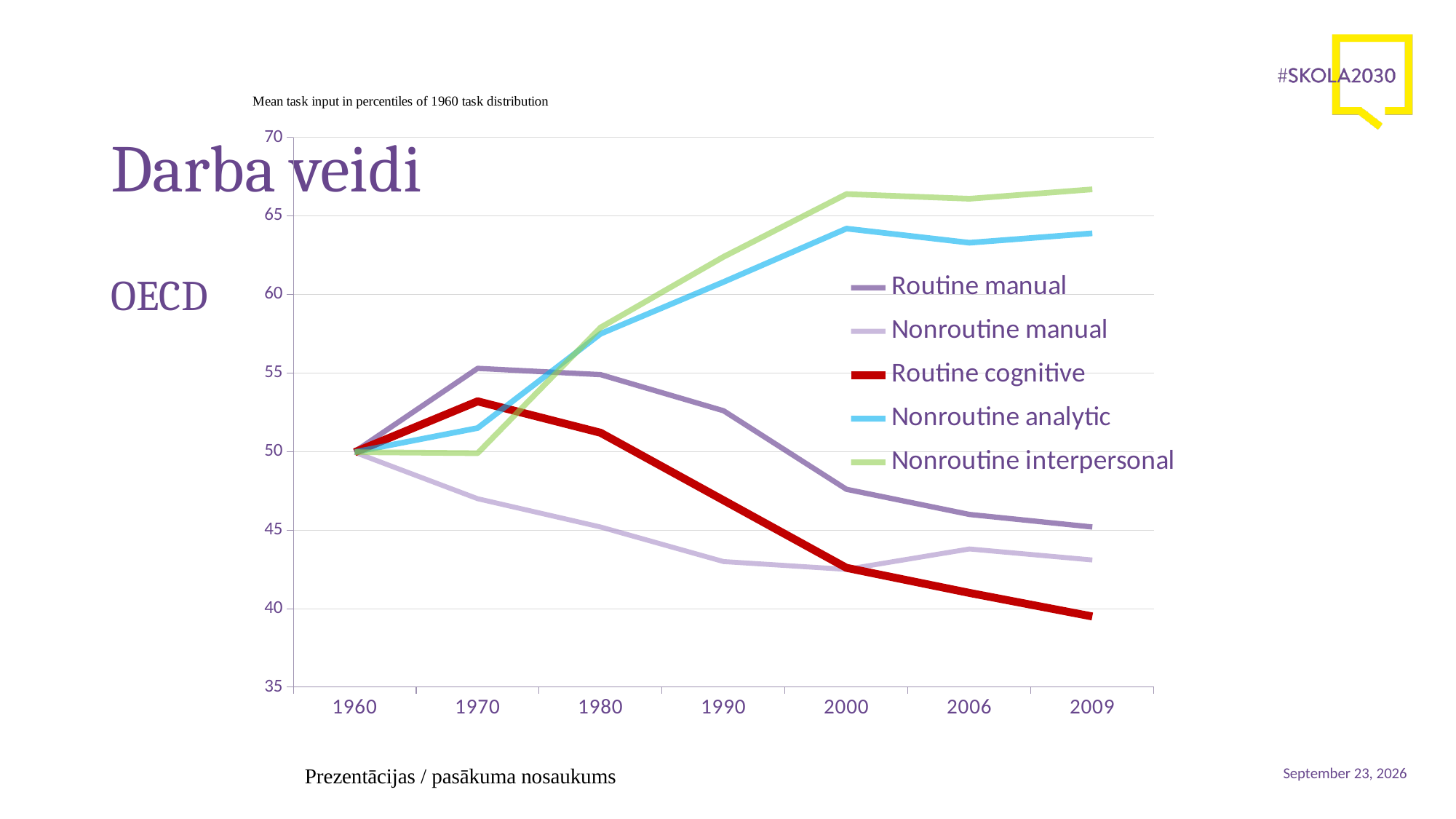
What is the title of the chart? Mean task input in percentiles of 1960 task distribution Is the value for Nonroutine analytic in 2000 greater or less than 60? greater How many series does the legend list? 5 Is the value for Nonroutine interpersonal in 2009 greater or less than 65? greater In 1970, which is larger: Routine manual or Nonroutine manual? Routine manual Is the value for Nonroutine manual in 1990 greater or less than 45? less What is the value for Routine cognitive in 1960? 50 Does the Routine cognitive series rise or fall from 1970 to 2009? fall How many years are marked on the x axis? 7 What kind of chart is shown on the slide? line chart Which series has the lowest value in 2009? Routine cognitive Which series has the highest value in 2009? Nonroutine interpersonal